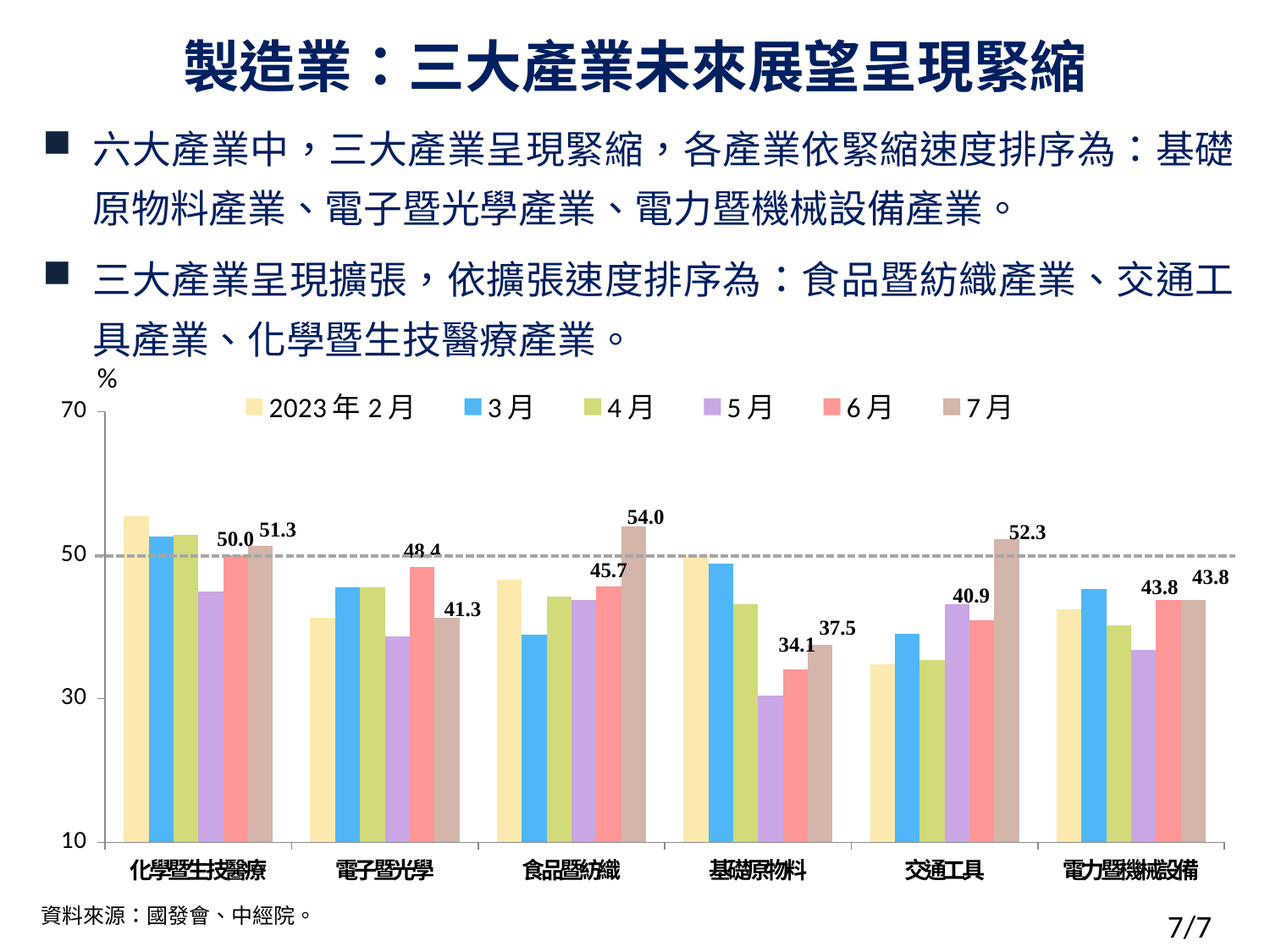
Which category has the lowest value in 6月? 基礎原物料 What is the value for 交通工具 in 7月? 52.3 How many industry categories are shown on the x axis? 6 Is the value for 電子暨光學 in 5月 greater or less than 50? less Is the value for 化學暨生技醫療 in 2023年2月 greater or less than 50? greater What is the value for 食品暨紡織 in 7月? 54.0 What is the difference between the 7月 and 6月 values for 交通工具? 11.4 What kind of chart is shown on the slide? bar chart How many series does the legend list? 6 What is the value for 基礎原物料 in 6月? 34.1 Which category has the highest value in 7月? 食品暨紡織 Which is larger for 電子暨光學: the 6月 value or the 7月 value? 6月